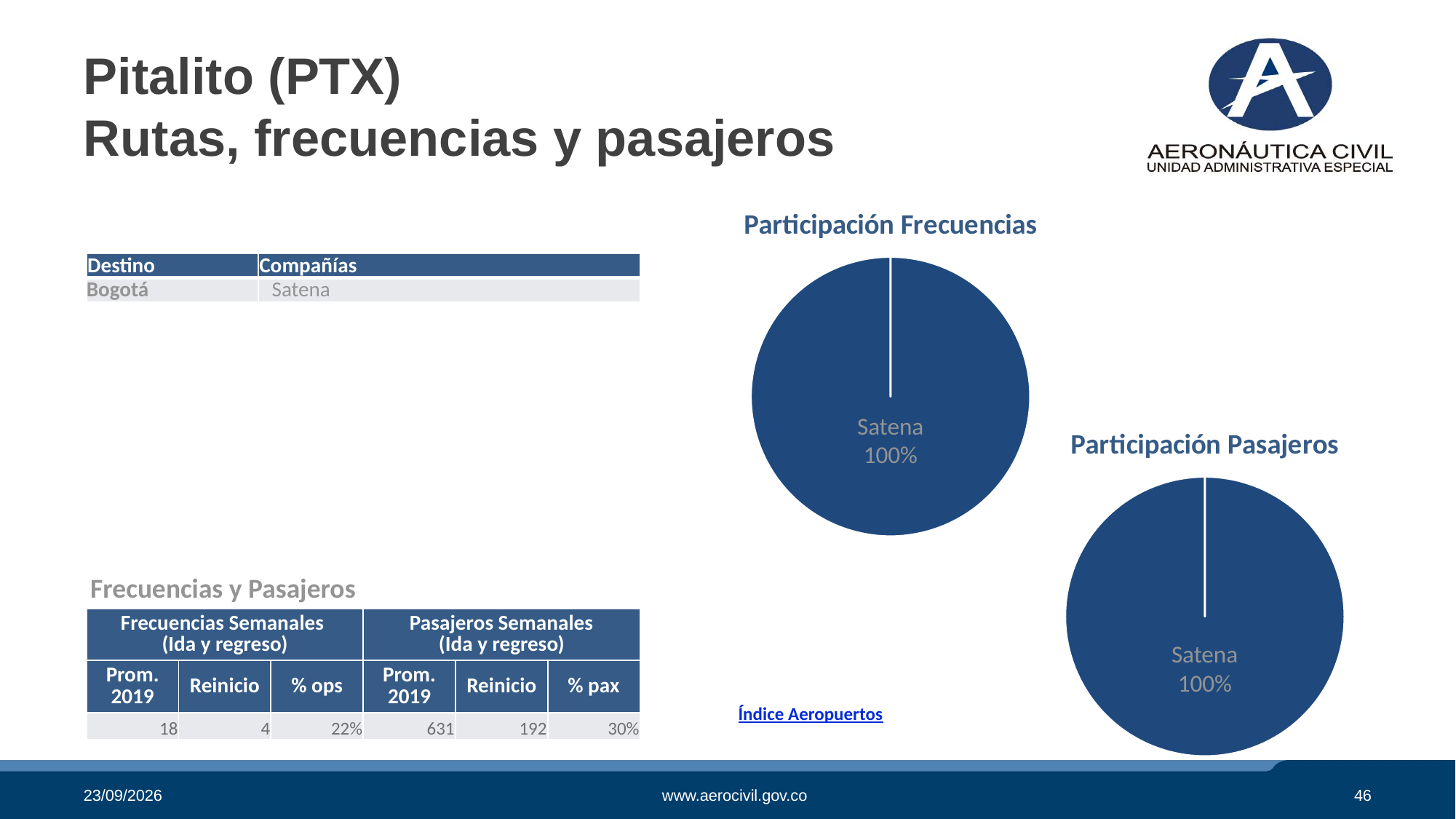
What is the title of the pie chart positioned at the upper right of the slide? Participación Frecuencias What kind of chart is 'Participación Pasajeros'? Pie chart In the 'Participación Frecuencias' chart, what share does Satena have? 100% How many slices does the 'Participación Pasajeros' pie chart have? 1 How many slices does the 'Participación Frecuencias' pie chart have? 1 Which company is shown in the 'Participación Frecuencias' chart? Satena In the 'Participación Pasajeros' chart, which company has the largest share? Satena What is the title of the pie chart positioned at the lower right of the slide? Participación Pasajeros Which company is shown in the 'Participación Pasajeros' chart? Satena In the 'Participación Frecuencias' chart, which company has the largest share? Satena In the 'Participación Pasajeros' chart, what share does Satena have? 100% What kind of chart is 'Participación Frecuencias'? Pie chart